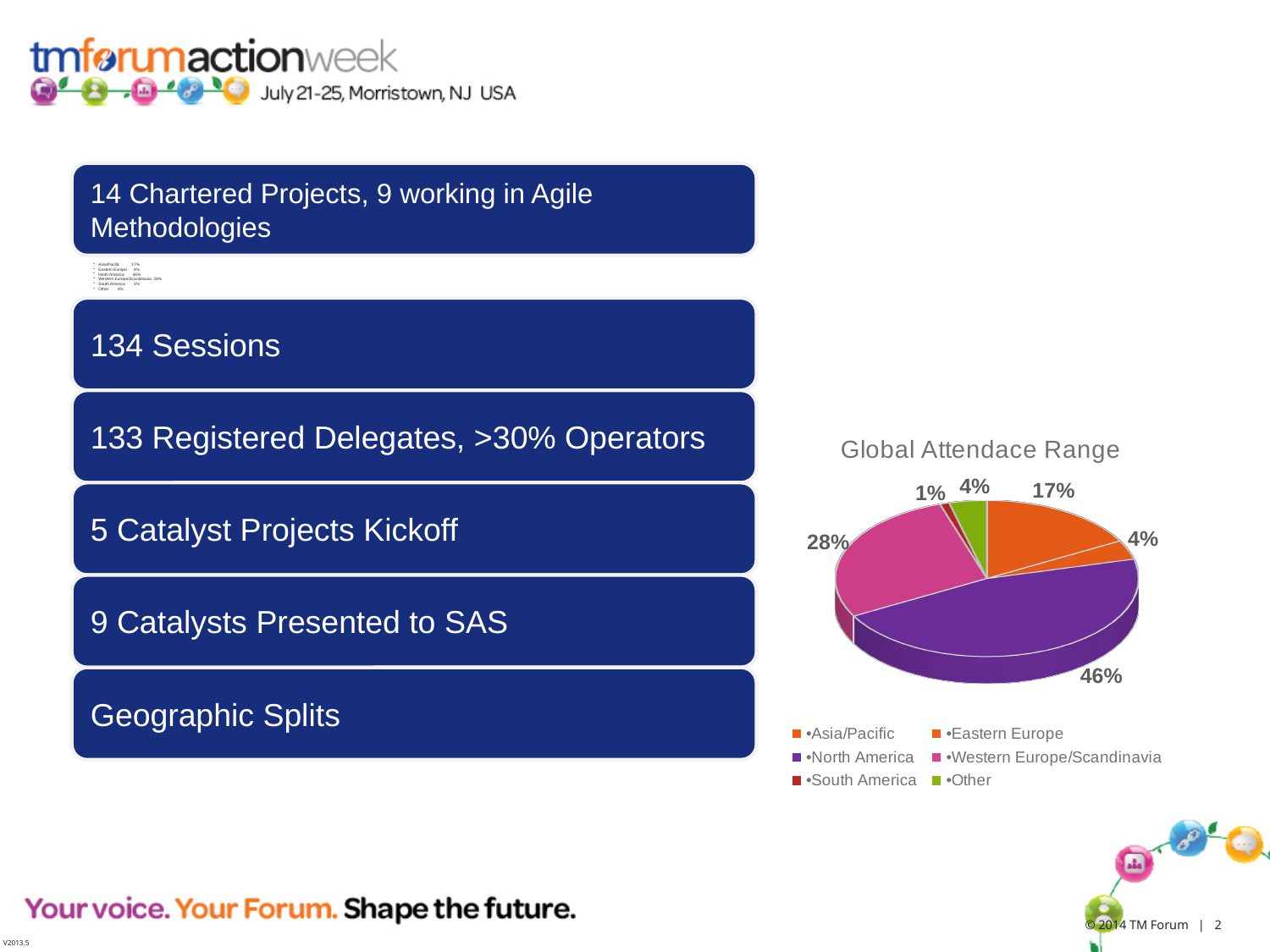
What is the difference in percentage points between North America and Western Europe/Scandinavia? 18 What share of the pie does Asia/Pacific have? 17% What share of the pie does South America have? 1% What share of the pie does Western Europe/Scandinavia have? 28% Which region has the smallest share of the pie? South America What share of the pie does North America have? 46% Which region has the largest share of the pie? North America What kind of chart is shown under the title "Global Attendace Range"? pie chart What share of the pie does Eastern Europe have? 4% What is the title of the pie chart? Global Attendace Range Which has a larger share, Asia/Pacific or Western Europe/Scandinavia? Western Europe/Scandinavia How many regions does the pie chart legend list? 6